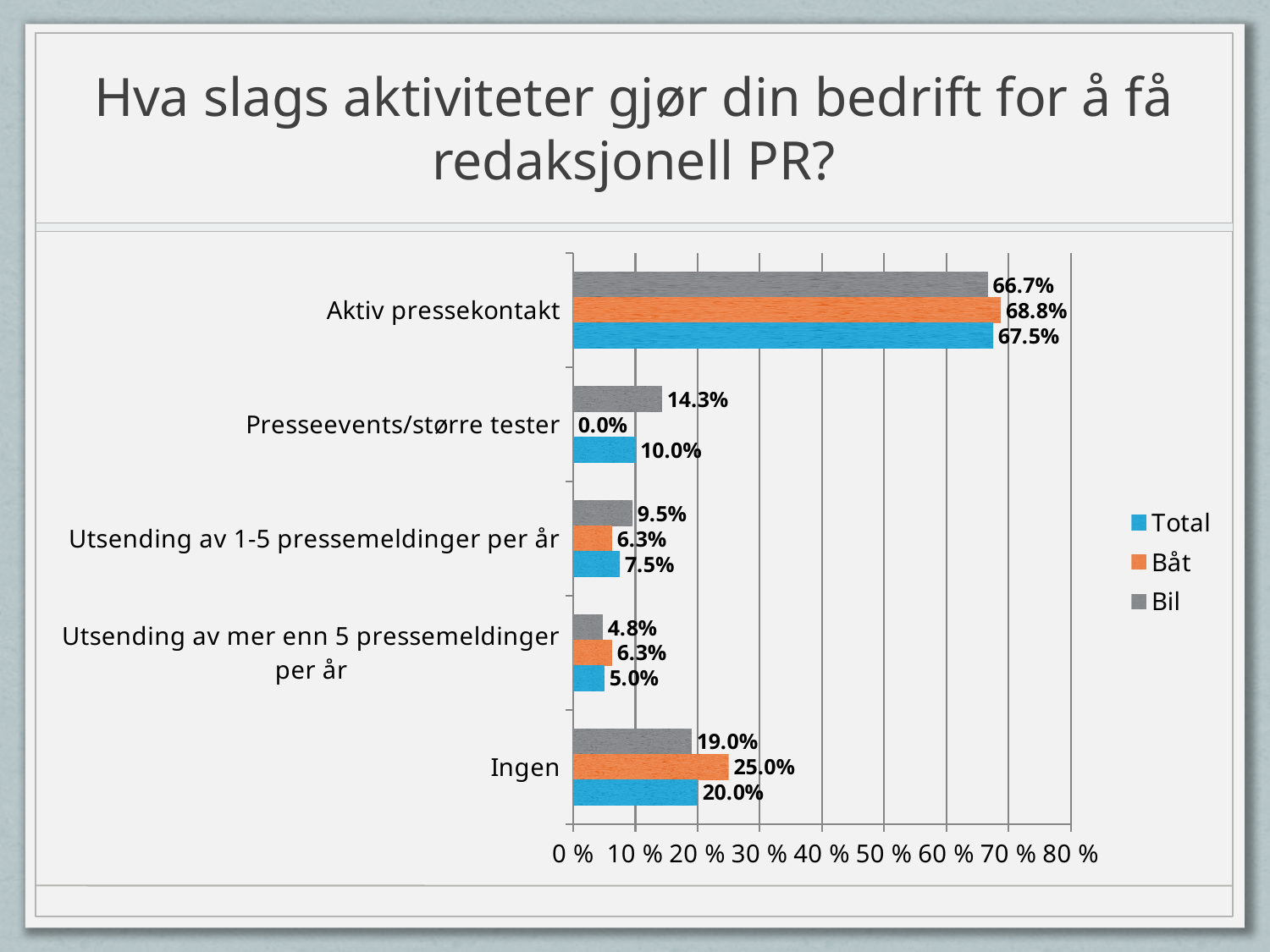
Which category has the highest Total value? Aktiv pressekontakt Which series is shown in orange? Båt What is the Bil value for Presseevents/større tester? 14.3% What is the difference between the Båt and Bil values for Ingen? 6.0% Which category has the lowest Bil value? Utsending av mer enn 5 pressemeldinger per år Which is larger for Utsending av 1-5 pressemeldinger per år, the Bil value or the Båt value? Bil How many categories are shown on the chart? 5 What is the Båt value for Aktiv pressekontakt? 68.8% What kind of chart is shown on the slide? Bar chart How many series does the legend list? 3 What is the Båt value for Presseevents/større tester? 0.0% What is the Total value for Ingen? 20.0%